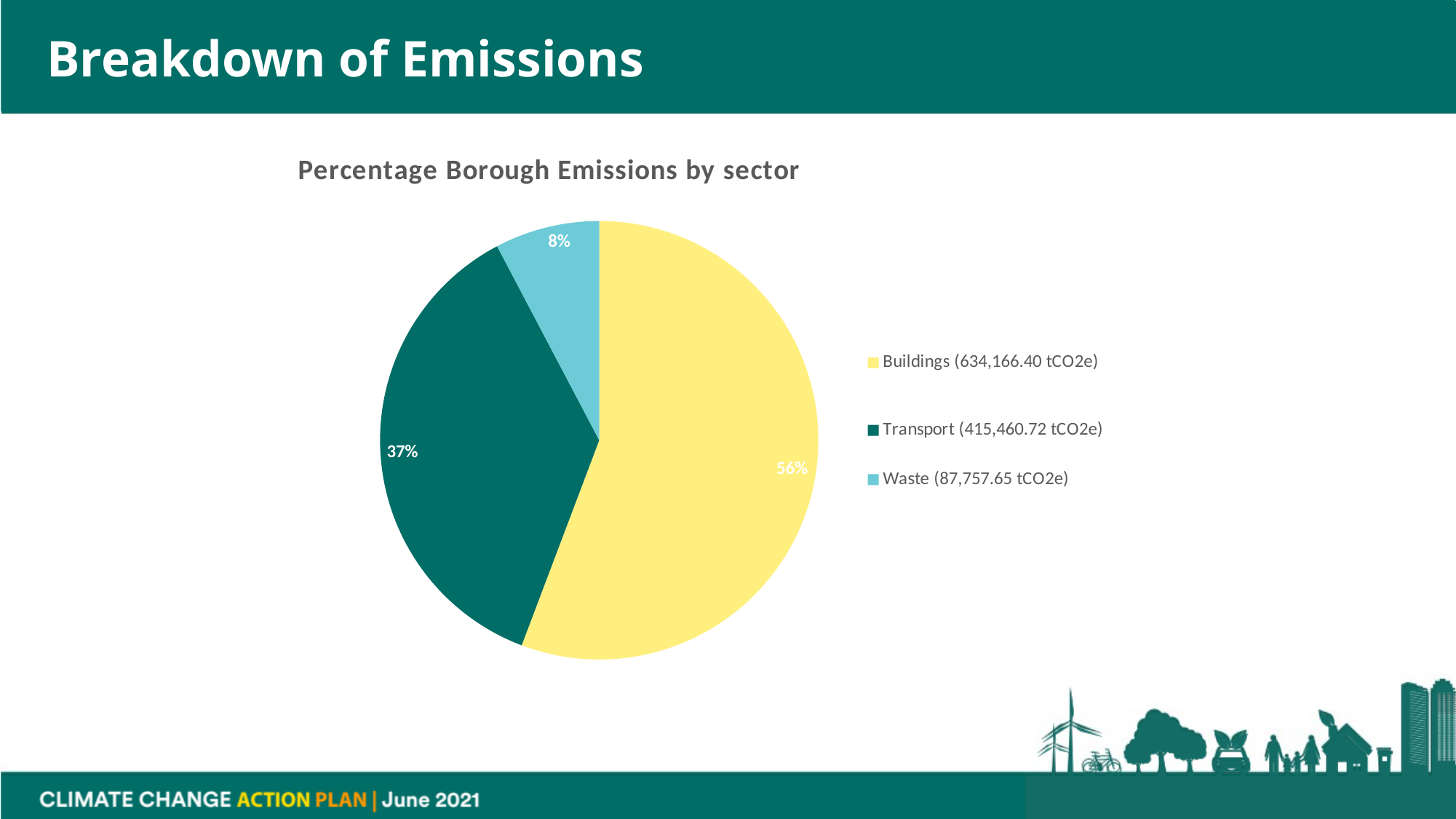
What percentage of borough emissions comes from Buildings? 56% What is the title of the chart? Percentage Borough Emissions by sector What emissions value in tCO2e does the legend give for Transport? 415,460.72 tCO2e What type of chart is shown on the slide? pie chart What is the difference in percentage points between the Buildings and Transport shares? 19 Which sector accounts for the smallest share of emissions? Waste How many sectors are shown in the pie chart? 3 Which sector has a larger share of emissions, Transport or Waste? Transport Which sector accounts for the largest share of emissions? Buildings What percentage of borough emissions comes from Waste? 8% What percentage of borough emissions comes from Transport? 37% Which colour represents the Waste sector in the pie chart? light blue